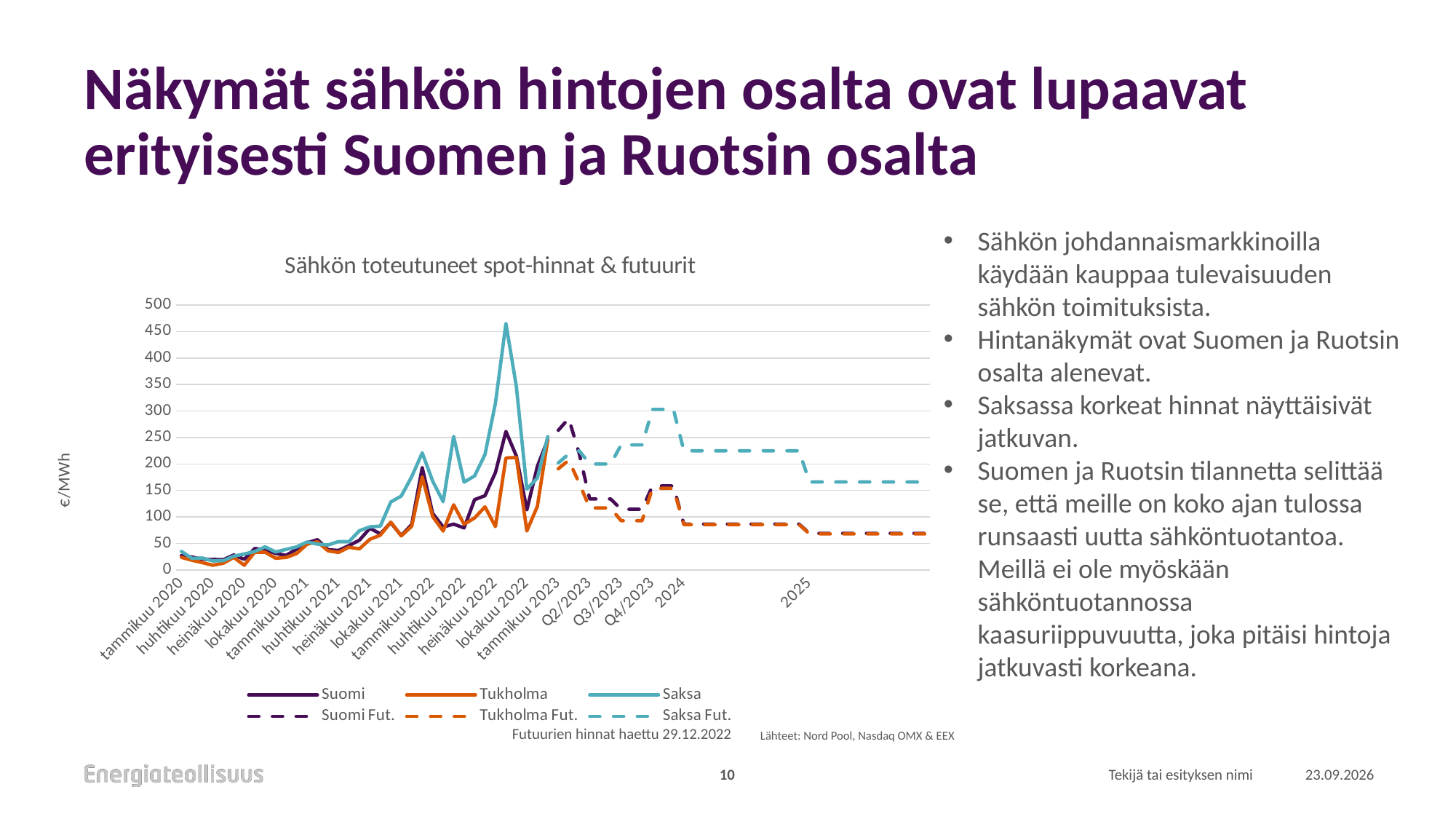
Which series reaches the highest peak value in the chart? Saksa Is the value of the Saksa Fut. series in 2025 greater or less than 150? greater Is the peak value of the Saksa series greater or less than 400? greater Is the value of the Suomi series in tammikuu 2020 greater or less than 100? less How many series does the chart legend list? 6 What is the title of the chart? Sähkön toteutuneet spot-hinnat & futuurit Does the Saksa Fut. series rise or fall from Q4/2023 to 2025? fall In 2025, which is higher: the Saksa Fut. series or the Suomi Fut. series? Saksa Fut. What kind of chart is shown on the slide? line chart What unit is shown on the vertical axis of the chart? €/MWh